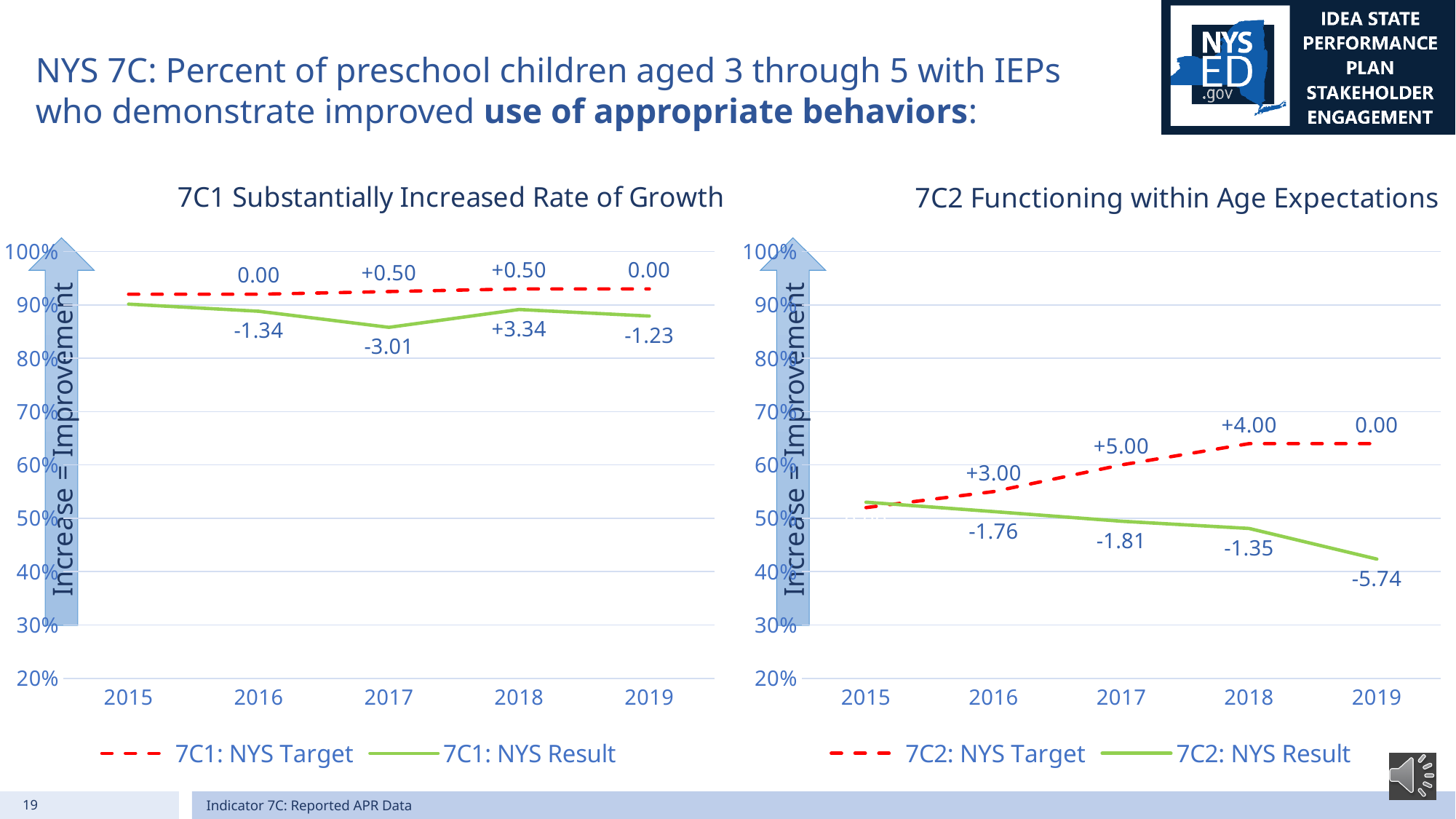
In the 7C2 Functioning within Age Expectations chart, does the 7C2: NYS Result line rise or fall from 2015 to 2019? fall In the 7C1 Substantially Increased Rate of Growth chart, what change label is printed for the 7C1: NYS Result in 2017? -3.01 What type of chart is the 7C1 Substantially Increased Rate of Growth chart? line chart In the 7C2 Functioning within Age Expectations chart, how many series does the legend list? 2 In the 7C2 Functioning within Age Expectations chart, what change label is printed for the 7C2: NYS Target in 2017? +5.00 In the 7C2 Functioning within Age Expectations chart, what change label is printed for the 7C2: NYS Result in 2019? -5.74 In the 7C1 Substantially Increased Rate of Growth chart, is the 7C1: NYS Result value for 2015 greater or less than 80%? greater How many years are shown on the x axis of the 7C1 Substantially Increased Rate of Growth chart? 5 In the 7C1 Substantially Increased Rate of Growth chart, what change label is printed for the 7C1: NYS Target in 2018? +0.50 In the 7C2 Functioning within Age Expectations chart, which year has the lowest 7C2: NYS Result value? 2019 In the 7C2 Functioning within Age Expectations chart, is the 7C2: NYS Result value for 2019 greater or less than 50%? less In the 7C2 Functioning within Age Expectations chart, does the 7C2: NYS Target line rise or fall from 2015 to 2018? rise